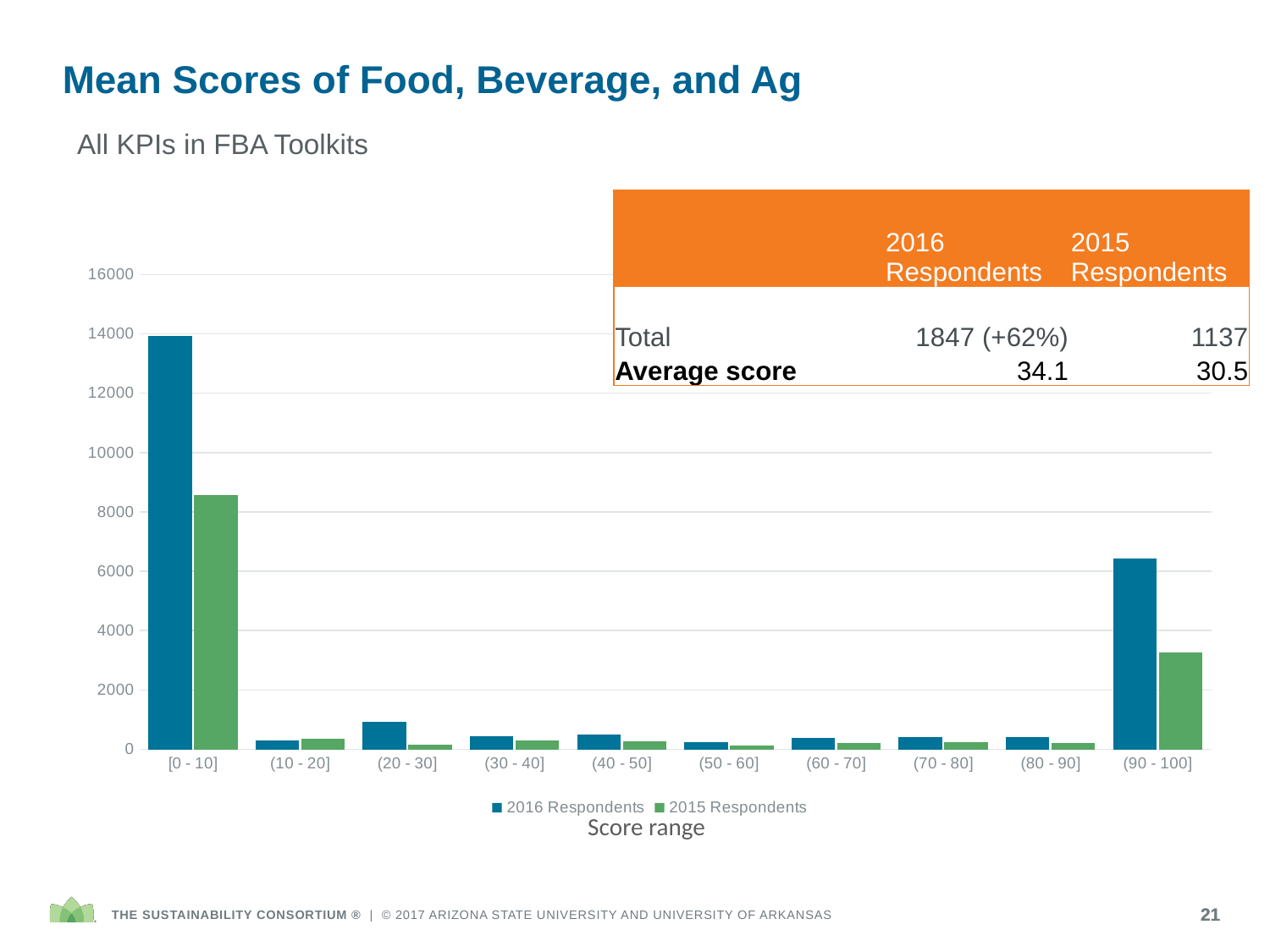
What kind of chart is shown on the slide? bar chart What is the label of the x axis? Score range Is the value for 2015 Respondents in the [0 - 10] score range greater or less than 10000? less Which score range has the highest value for 2015 Respondents? [0 - 10] Is the value for 2015 Respondents in the (90 - 100] score range greater or less than 4000? less In the (90 - 100] score range, which series has the larger value, 2016 Respondents or 2015 Respondents? 2016 Respondents Is the value for 2016 Respondents in the (90 - 100] score range greater or less than 6000? greater Which score range has the highest value for 2016 Respondents? [0 - 10] How many score range categories are shown on the x axis? 10 What are the two series named in the legend? 2016 Respondents and 2015 Respondents How many series does the chart legend list? 2